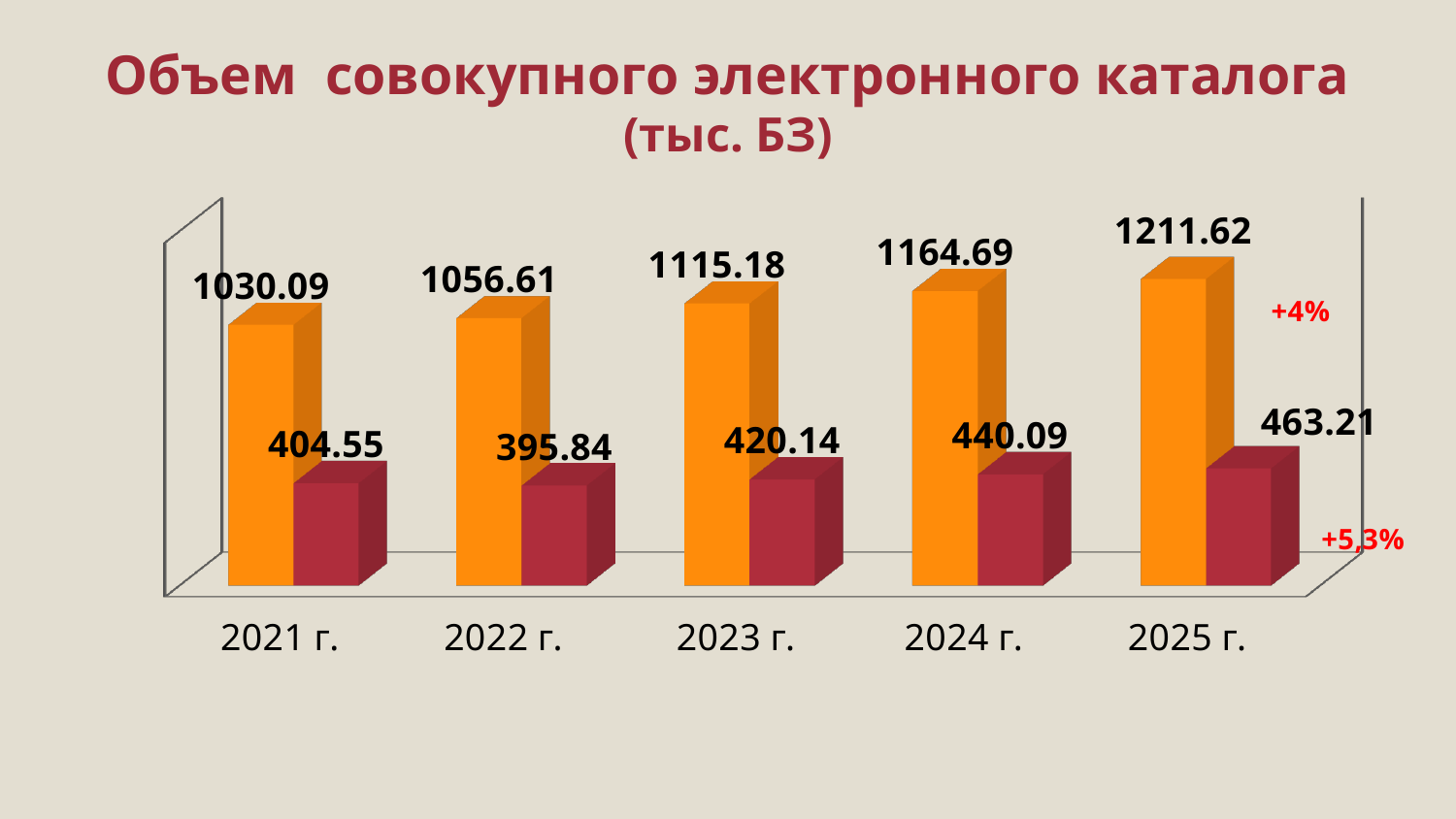
Which is larger: the red bar for 2021 г. or the red bar for 2022 г.? 2021 г. What is the value of the red bar for 2023 г.? 420.14 How many years are shown on the x axis? 5 What kind of chart is shown on the slide? Bar chart What is the value of the orange bar for 2021 г.? 1030.09 Which year has the highest value for the orange bars? 2025 г. What is the difference between the orange bar values for 2025 г. and 2024 г.? 46.93 What is the title of the chart? Объем совокупного электронного каталога (тыс. БЗ) Which year has the lowest value for the red bars? 2022 г. Do the orange bar values rise or fall from 2021 г. to 2025 г.? Rise What is the difference between the red bar values for 2025 г. and 2021 г.? 58.66 What is the value of the orange bar for 2025 г.? 1211.62